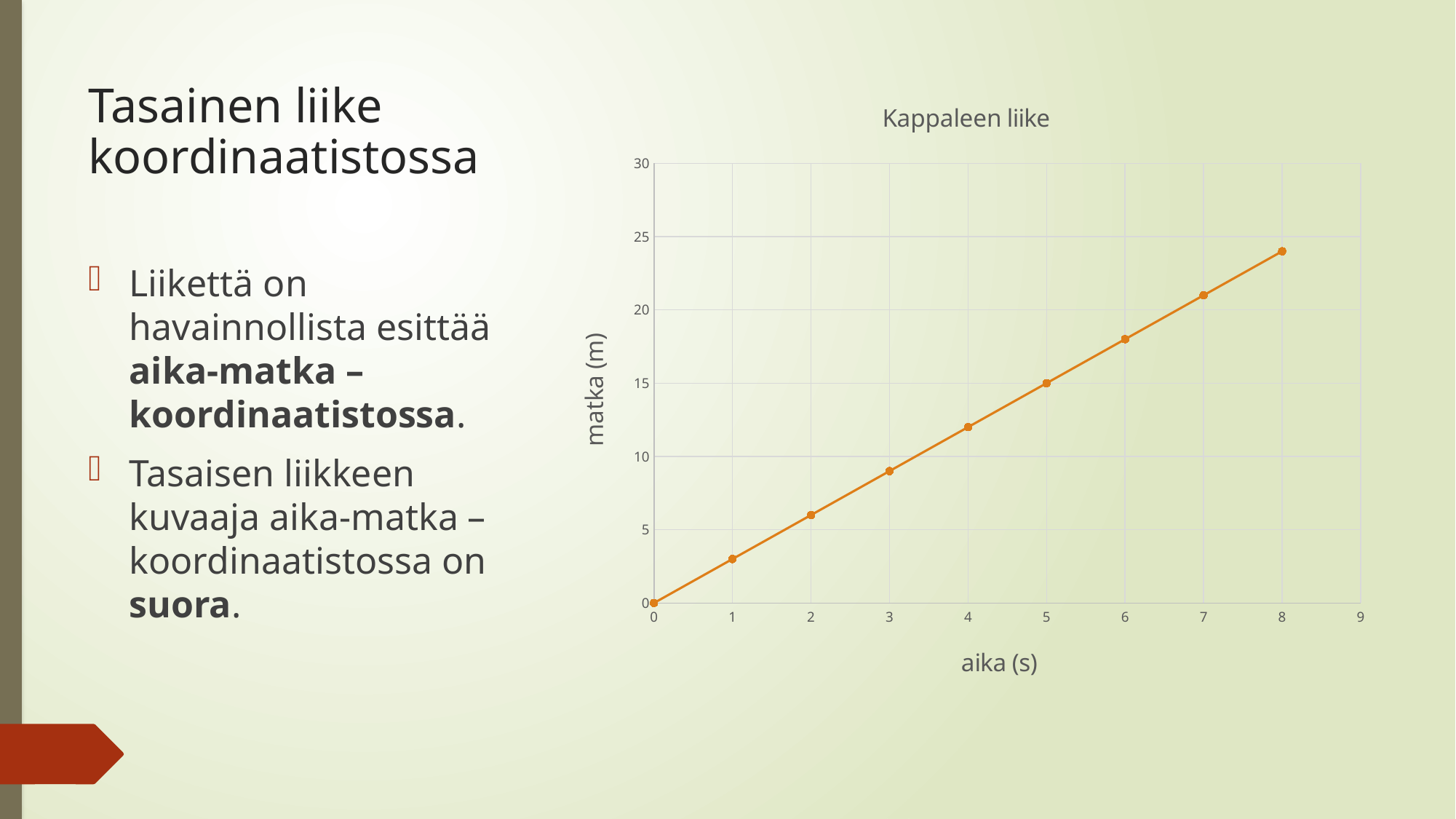
At which aika value is matka highest? 8 What is the value of matka (m) at aika = 0 s? 0 What is the label of the x axis? aika (s) How many data points are plotted on the line? 9 What is the value of matka (m) at aika = 5 s? 15 Is the value of matka at aika = 7 s greater or less than 25? less Is the value of matka at aika = 2 s greater or less than 10? less Is the value of matka at aika = 8 s greater or less than 20? greater What kind of chart is shown on the slide? line chart Which is larger, the matka value at aika = 3 s or at aika = 6 s? aika = 6 s What is the title of the chart? Kappaleen liike Do the values rise or fall as time (aika) increases along the x axis? rise